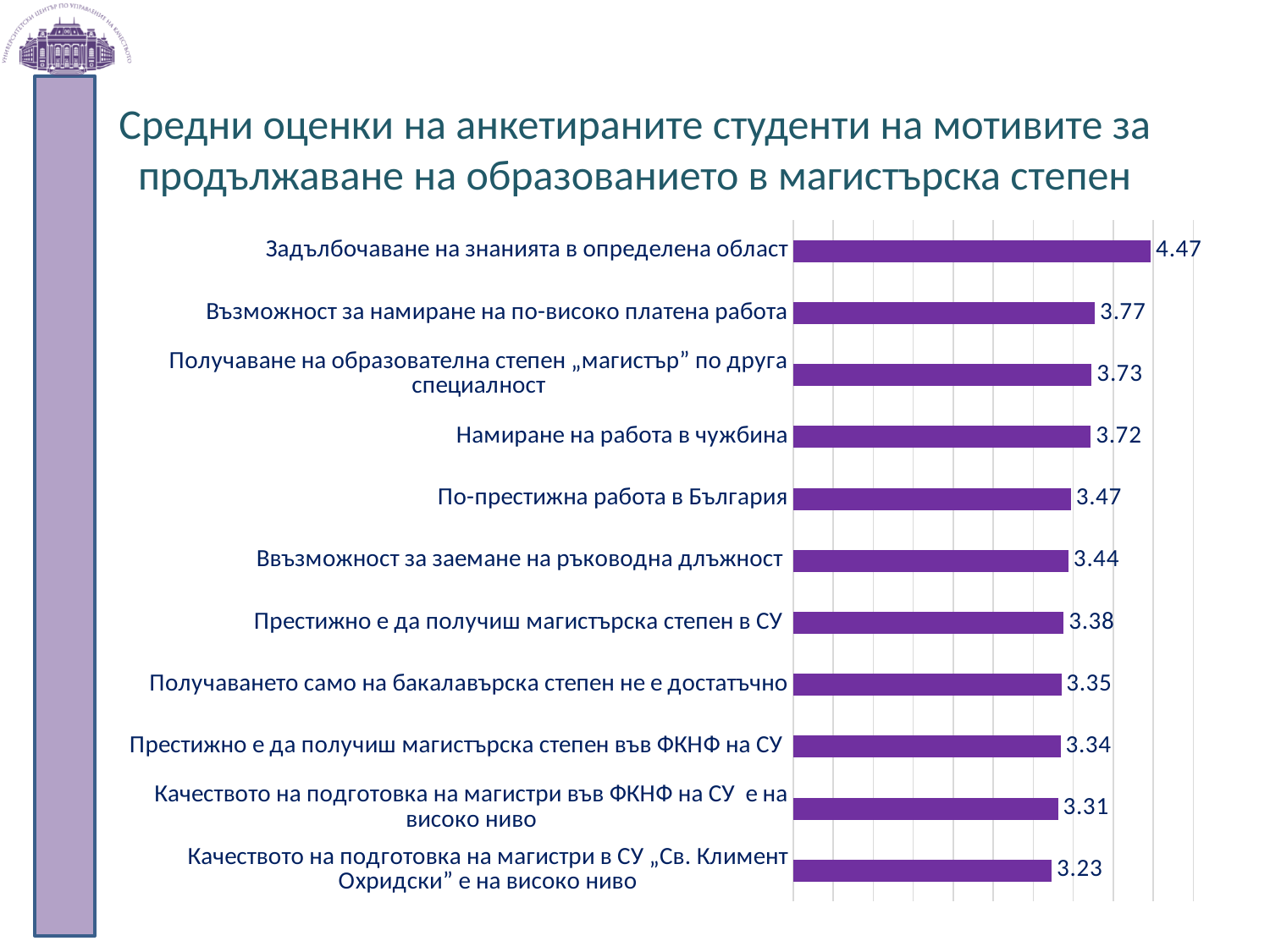
Which motive has the highest average score? Задълбочаване на знанията в определена област Which motive has the lowest average score? Качеството на подготовка на магистри в СУ „Св. Климент Охридски” е на високо ниво Which has a higher score: "По-престижна работа в България" or "Получаването само на бакалавърска степен не е достатъчно"? По-престижна работа в България What is the score for "Ввъзможност за заемане на ръководна длъжност"? 3.44 What is the difference between the scores for "По-престижна работа в България" and "Качеството на подготовка на магистри в СУ „Св. Климент Охридски” е на високо ниво"? 0.24 What is the average score for "Задълбочаване на знанията в определена област"? 4.47 What is the average score for "Намиране на работа в чужбина"? 3.72 What colour are the bars in the chart? Purple What is the average score for "Престижно е да получиш магистърска степен във ФКНФ на СУ"? 3.34 What is the difference between the scores for "Задълбочаване на знанията в определена област" and "Възможност за намиране на по-високо платена работа"? 0.70 How many motives (categories) are shown in the chart? 11 What type of chart is shown on the slide? Bar chart